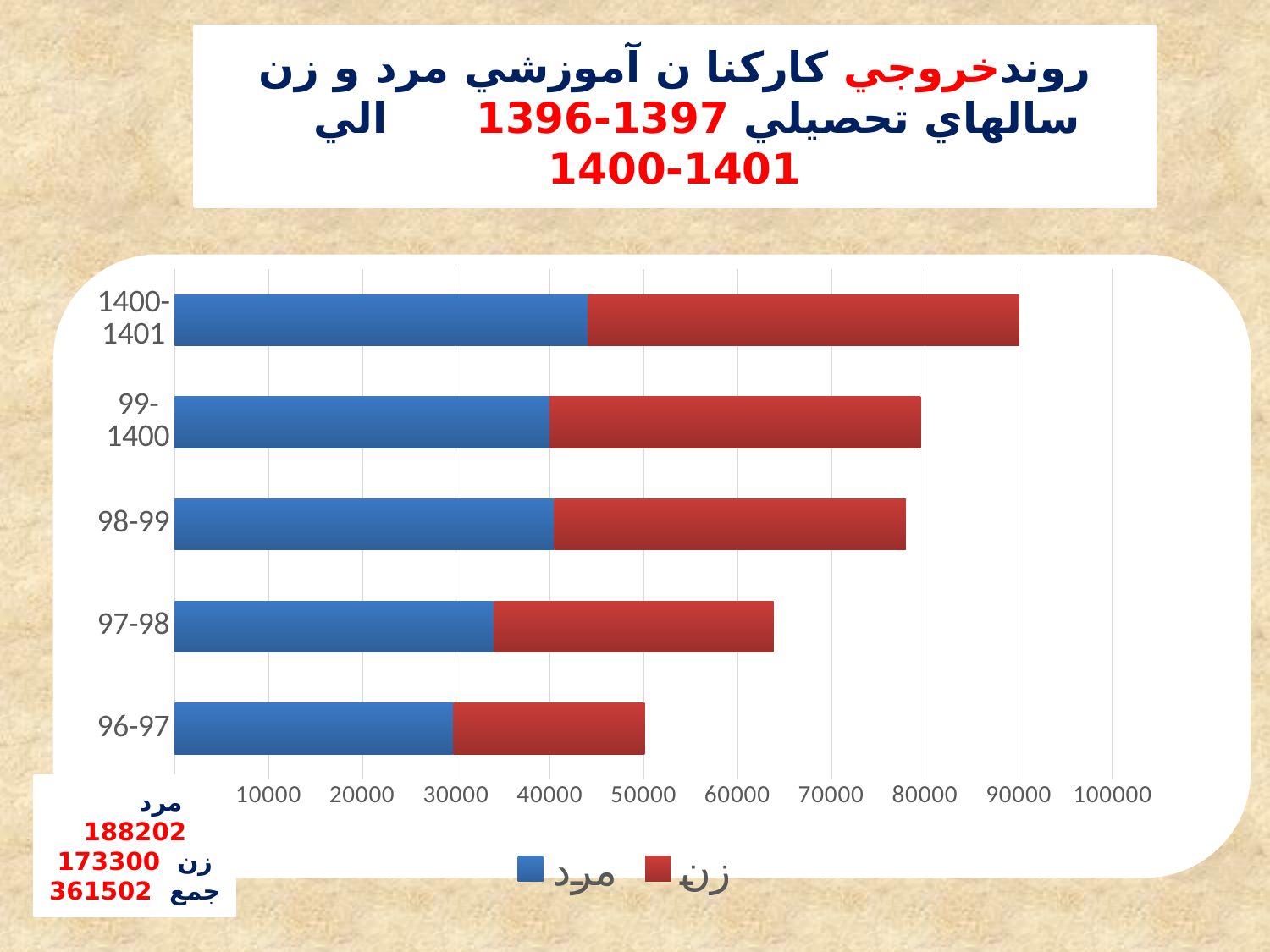
According to the text box on the slide, what is the overall total (جمع) shown? 361502 How many series does the legend list? 2 Is the total bar for 98-99 greater or less than 80000? less Which is larger, the total bar for 1400-1401 or the total bar for 96-97? 1400-1401 Which colour represents the زن series in the legend? red Is the مرد (blue) value for 1400-1401 greater or less than 40000? greater Which academic year has the longest total bar? 1400-1401 What kind of chart is shown on the slide? stacked bar chart Which academic year has the shortest total bar? 96-97 Do the total bar lengths rise or fall from 96-97 up to 1400-1401? rise Is the total bar for 97-98 greater or less than 60000? greater How many academic-year categories are plotted on the chart? 5